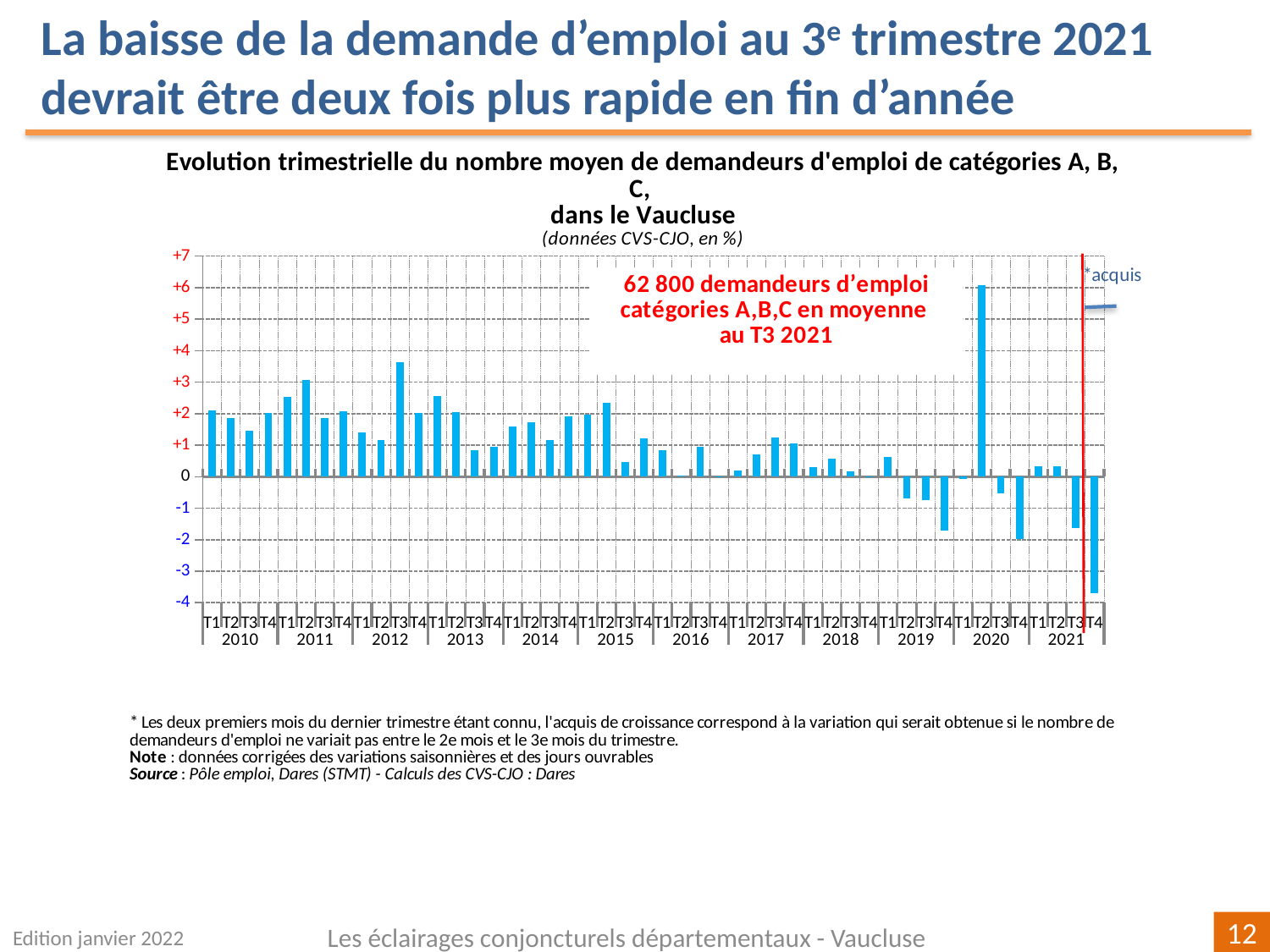
How many years are shown on the x axis of the chart? 12 Which is larger, the value for T4 2020 or the value for T4 2021? T4 2020 Is the value for T4 2021 greater or less than -3? less Which is larger, the value for T3 2012 or the value for T2 2011? T3 2012 Is the value for T3 2012 greater or less than +3? greater Which quarter has the highest value in the chart? T2 2020 Is the value for T2 2020 greater or less than +5? greater Which quarter has the lowest value in the chart? T4 2021 According to the annotation on the chart, how many demandeurs d'emploi catégories A,B,C were there on average in T3 2021? 62 800 Do the values rise or fall across the four quarters of 2021? fall What kind of chart is shown on the slide? bar chart